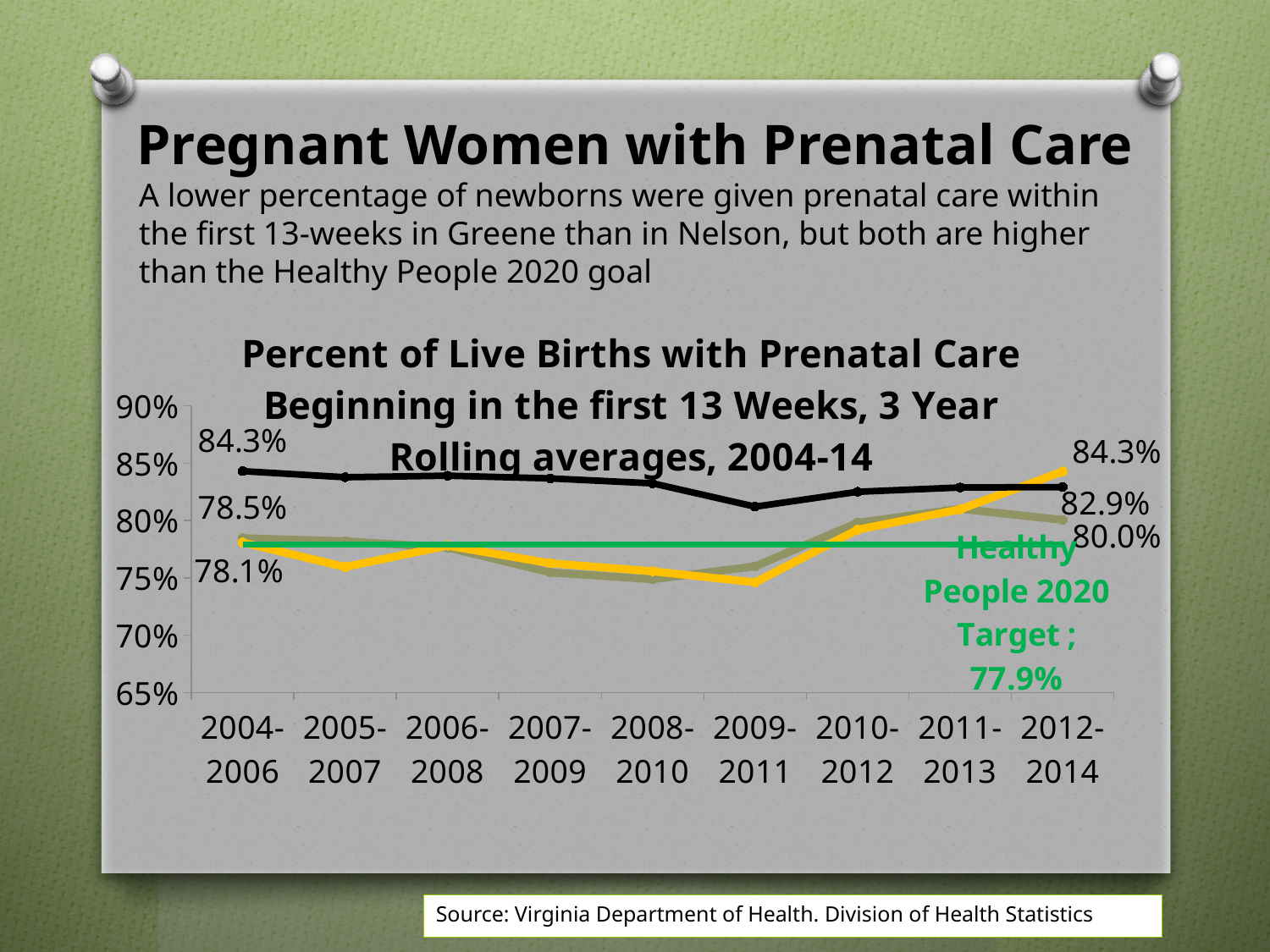
Does the yellow line rise or fall from 2009-2011 to 2012-2014? Rises How many three-year periods are shown along the x axis of the chart? 9 What is the lowest value labeled for the 2004-2006 period? 78.1% What kind of chart is shown on the slide? Line chart Is the value of the yellow line for 2009-2011 greater or less than 80%? less What is the difference between the highest and lowest labeled values for the 2004-2006 period? 6.2 percentage points What is the first period labeled on the x axis of the chart? 2004-2006 What is the highest value labeled for the 2004-2006 period? 84.3% Is the value of the black line for 2009-2011 greater or less than 85%? less What is the lowest value labeled for the 2012-2014 period? 80.0% What is the difference between the highest and lowest labeled values for the 2012-2014 period? 4.3 percentage points What is the Healthy People 2020 Target value shown on the chart? 77.9%